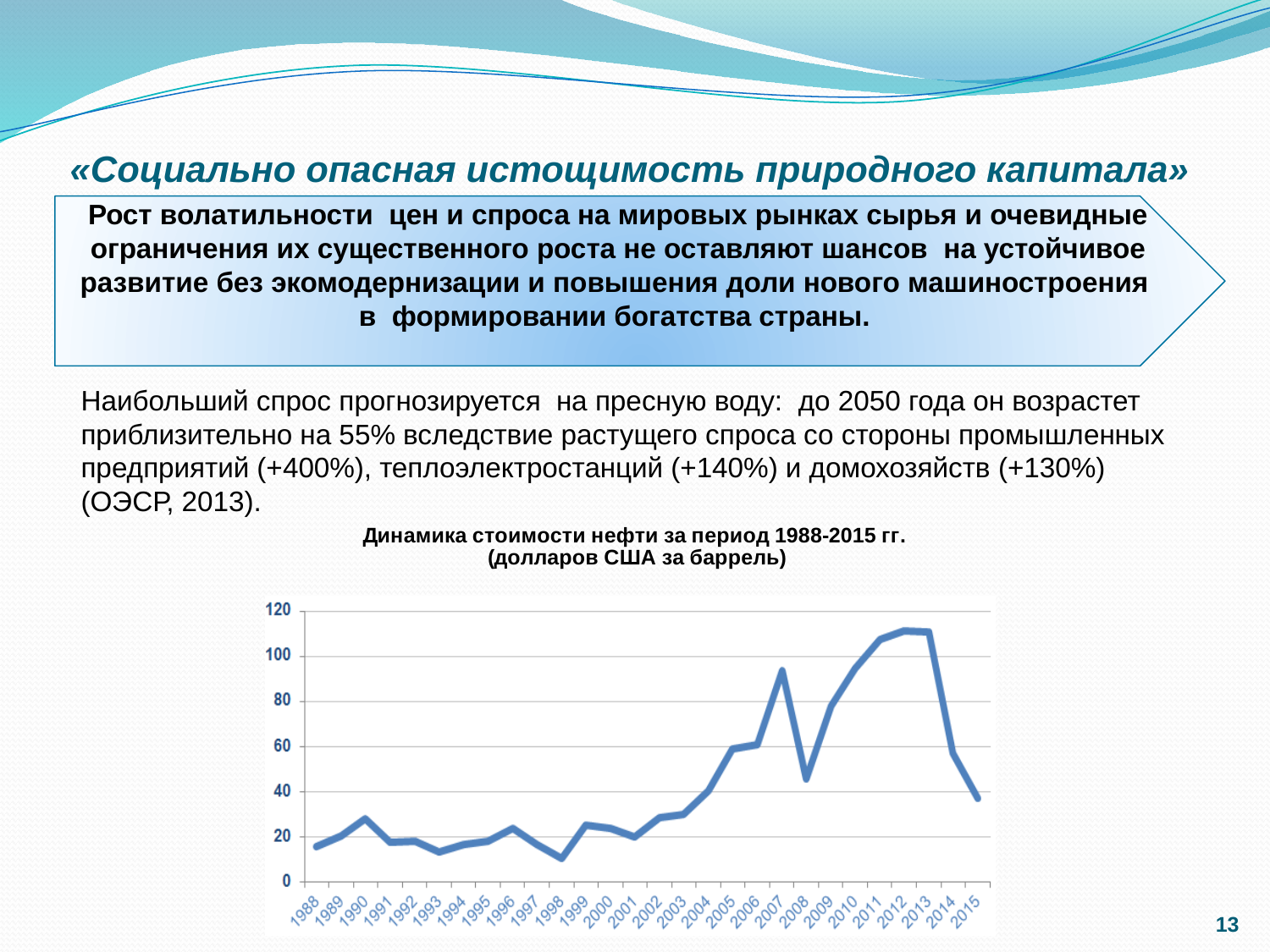
Is the value for 2014 greater or less than 80? less How many years are plotted on the x axis of the chart? 28 What is the title of the chart? Динамика стоимости нефти за период 1988-2015 гг. (долларов США за баррель) Do the values rise or fall from 2013 to 2015? fall Do the values rise or fall from 2008 to 2012? rise Is the value for 1990 greater or less than 20? greater Is the value for 2008 greater or less than 60? less What kind of chart is shown on the slide? line chart Which year has the higher oil price, 2007 or 2008? 2007 In which year is the oil price lowest on the chart? 1998